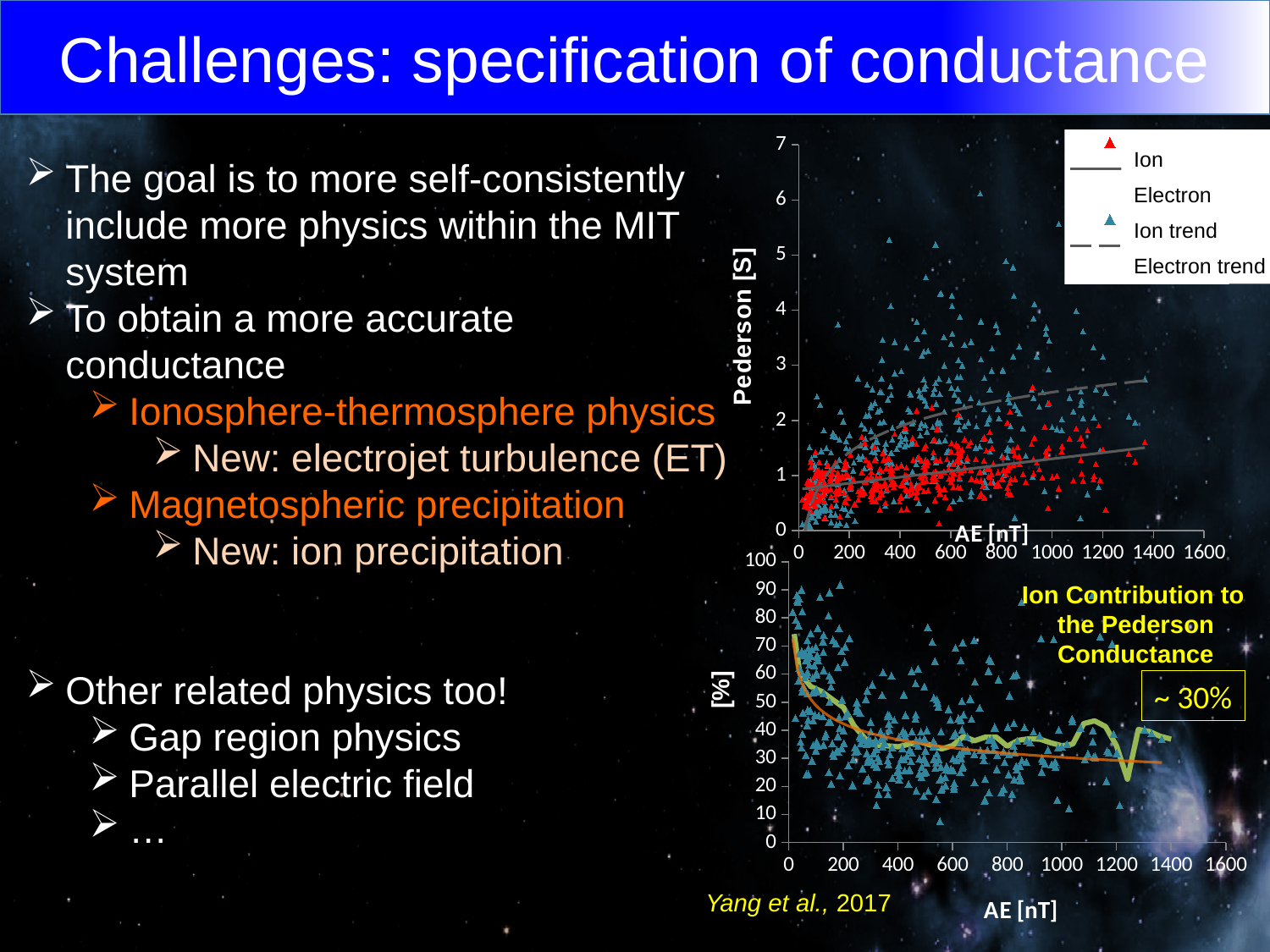
In the bottom chart, does the fitted trend line rise or fall as AE increases from 0 to 1400 nT? fall What is the title of the bottom chart? Ion Contribution to the Pederson Conductance In the top chart, is the Electron trend value at AE = 1200 nT greater or less than 2? greater In the top chart, do the Ion trend and Electron trend lines rise or fall as AE increases? rise What kind of chart is the top chart showing Pederson [S] against AE [nT]? scatter chart How many series does the legend of the top chart list? 4 In the top chart, which trend line is higher at AE = 1200 nT, the Ion trend or the Electron trend? Electron trend In the top chart, is the Ion trend value at AE = 1200 nT greater or less than 2? less In the bottom chart, is the trend line value at AE = 0 nT greater or less than 60? greater What value is printed in the annotation box on the bottom chart? ~ 30% What is the highest tick value on the y axis of the top chart? 7